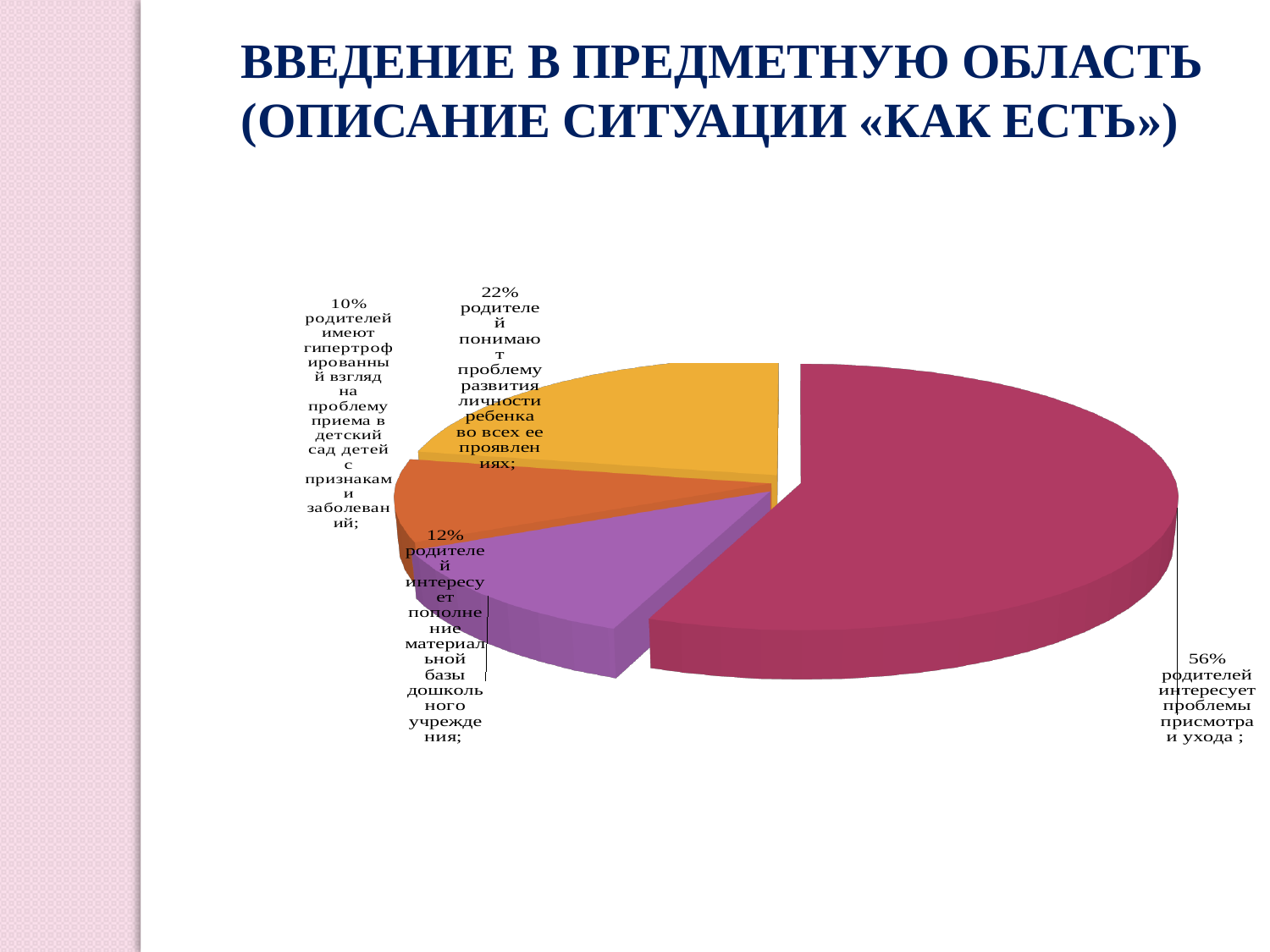
What colour is the largest slice of the pie chart? crimson (dark pink-red) What share of parents are interested in replenishing the material base of the preschool institution? 12% What kind of chart is shown on the slide? pie chart How many slices does the pie chart have? 4 Which category has the largest slice of the pie? 56% родителей интересует проблемы присмотра и ухода What is the combined share of the two smallest slices (12% and 10%)? 22% What share of parents understand the problem of the child's personality development in all its manifestations? 22% What is the difference between the share of parents interested in supervision and care and the share who understand the problem of personality development? 34% What share of parents are interested in problems of supervision and care (присмотра и ухода)? 56% Which is larger: the share of parents interested in replenishing the material base or the share who understand the problem of personality development? the share who understand the problem of personality development (22%) Which category has the smallest slice of the pie? 10% родителей имеют гипертрофированный взгляд на проблему приема в детский сад детей с признаками заболеваний What share of parents have a hypertrophied view of admitting children with signs of illness to kindergarten? 10%